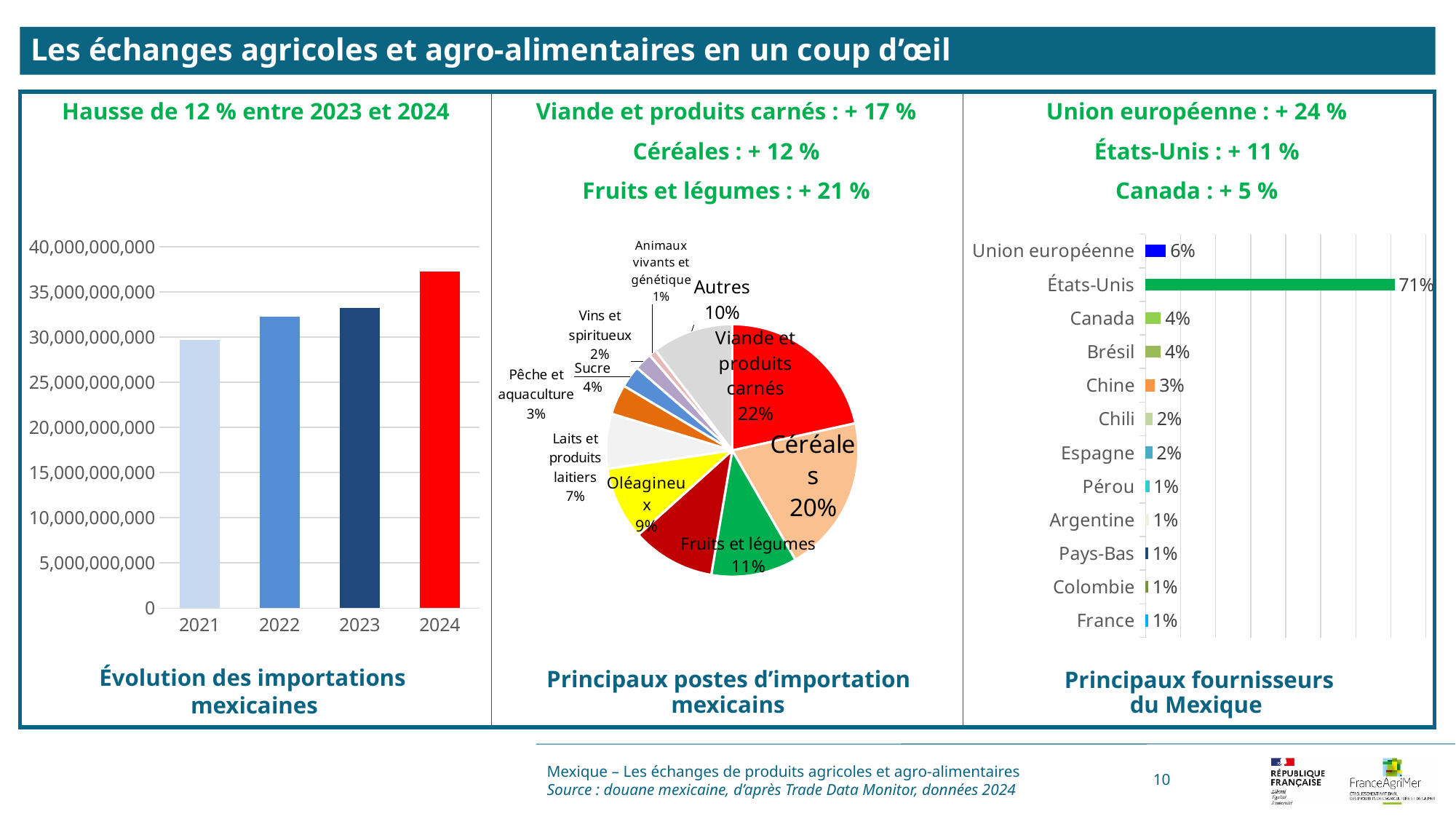
On the pie chart titled 'Principaux postes d'importation mexicains', how many slices are there? 11 On the pie chart titled 'Principaux postes d'importation mexicains', what share is Céréales? 20% On the chart titled 'Principaux fournisseurs du Mexique', what is the value for États-Unis? 71% On the chart titled 'Principaux fournisseurs du Mexique', which is larger, Chine or Chili? Chine On the chart titled 'Principaux fournisseurs du Mexique', what is the difference between États-Unis and Union européenne? 65 percentage points On the chart titled 'Évolution des importations mexicaines', how many years are plotted? 4 On the pie chart titled 'Principaux postes d'importation mexicains', what share is Fruits et légumes? 11% On the chart titled 'Évolution des importations mexicaines', is the value for 2024 greater or less than 35,000,000,000? greater On the chart titled 'Évolution des importations mexicaines', what kind of chart is shown? Bar chart On the chart titled 'Évolution des importations mexicaines', do the values rise or fall from 2021 to 2024? Rise On the pie chart titled 'Principaux postes d'importation mexicains', which category has the largest share? Viande et produits carnés On the chart titled 'Évolution des importations mexicaines', which year has the lowest value? 2021